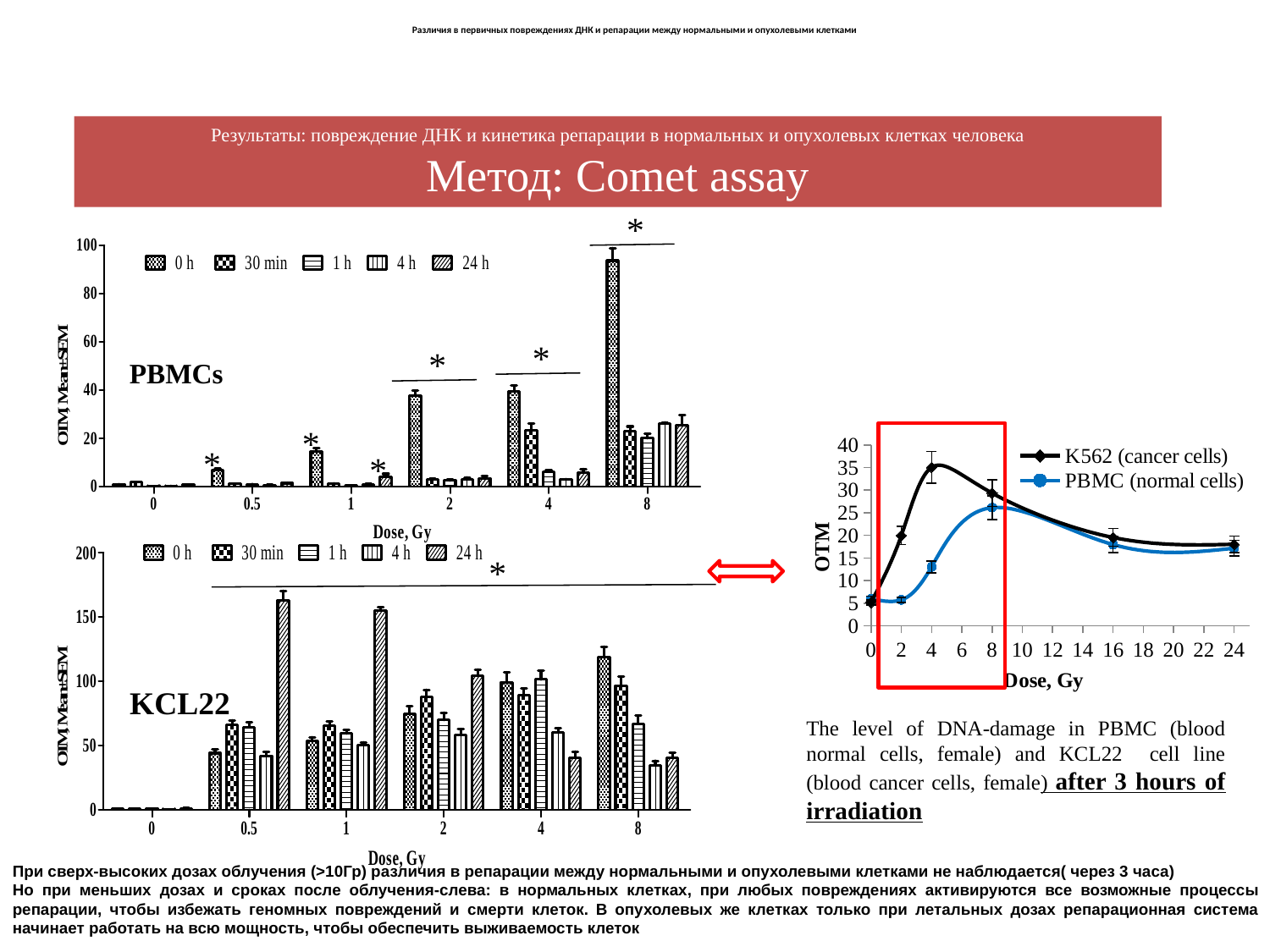
What kind of chart is the OTM vs Dose chart on the right of the slide? line chart In the PBMCs chart, is the 0 h bar at 8 Gy greater or less than 80? greater In the PBMCs chart, at which dose is the tallest bar found? 8 Gy How many dose categories are shown on the x axis of the KCL22 chart? 6 In the right-hand OTM line chart, which series has the larger value at 4 Gy, K562 (cancer cells) or PBMC (normal cells)? K562 (cancer cells) In the KCL22 chart, which series has the tallest bar at 0.5 Gy? 24 h In the KCL22 chart, is the 24 h bar at 0.5 Gy greater or less than 150? greater What is the y-axis label of the right-hand line chart? OTM How many series does the legend of the right-hand OTM line chart list? 2 In the right-hand OTM line chart, does the K562 (cancer cells) line rise or fall between 4 Gy and 24 Gy? fall How many series does the legend of the PBMCs chart list? 5 What kind of chart is the PBMCs chart on the left of the slide? bar chart